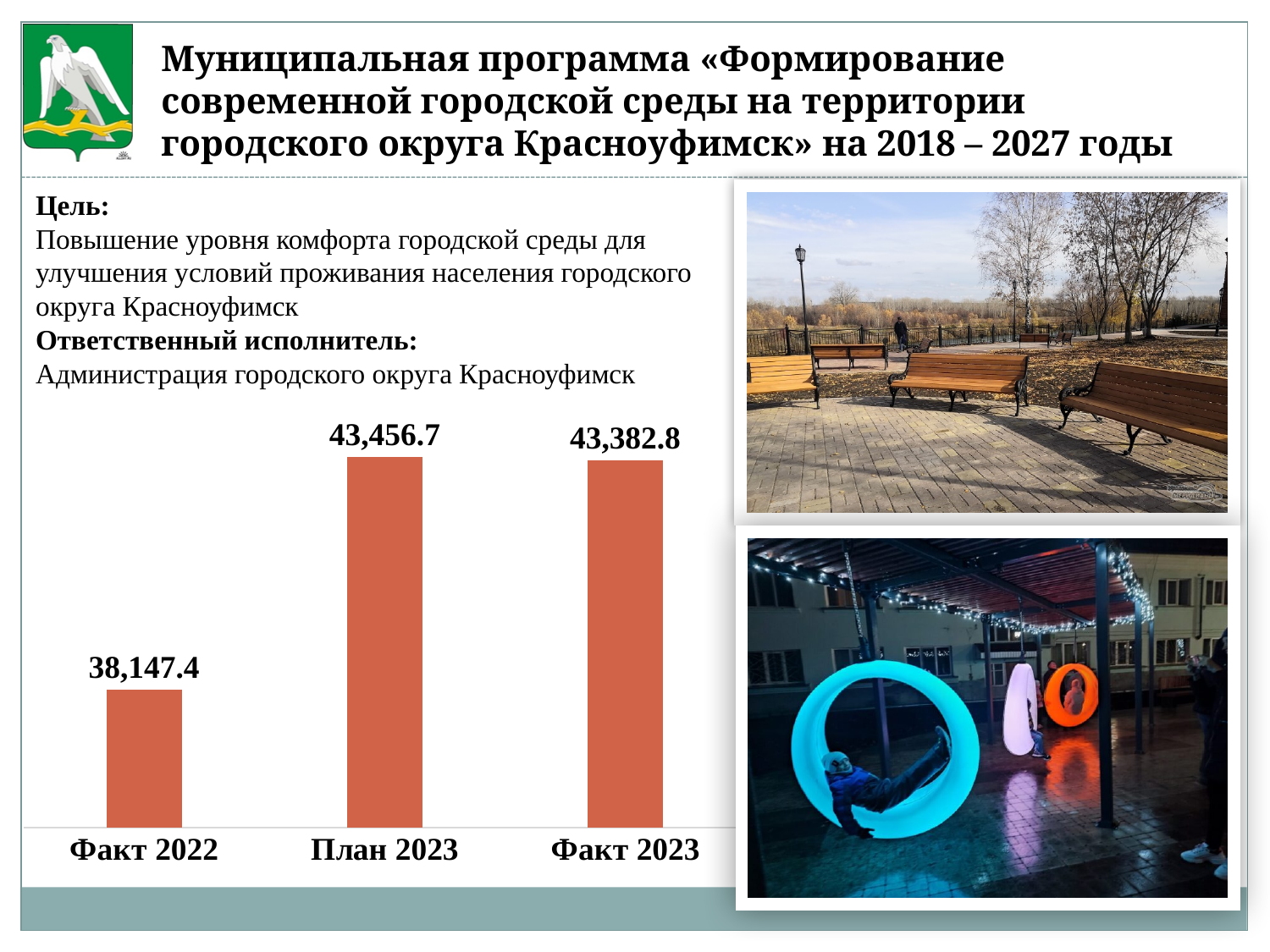
Does the value rise or fall from Факт 2022 to План 2023? Rise What is the value for Факт 2022? 38,147.4 What is the difference between Факт 2023 and Факт 2022? 5,235.4 What is the difference between План 2023 and Факт 2023? 73.9 What kind of chart is shown on the slide? Bar chart How many categories are shown in the chart? 3 What is the difference between План 2023 and Факт 2022? 5,309.3 What is the value for План 2023? 43,456.7 What is the value for Факт 2023? 43,382.8 Which category has the lowest value? Факт 2022 Which category has the highest value? План 2023 Which is larger, the value for План 2023 or the value for Факт 2023? План 2023